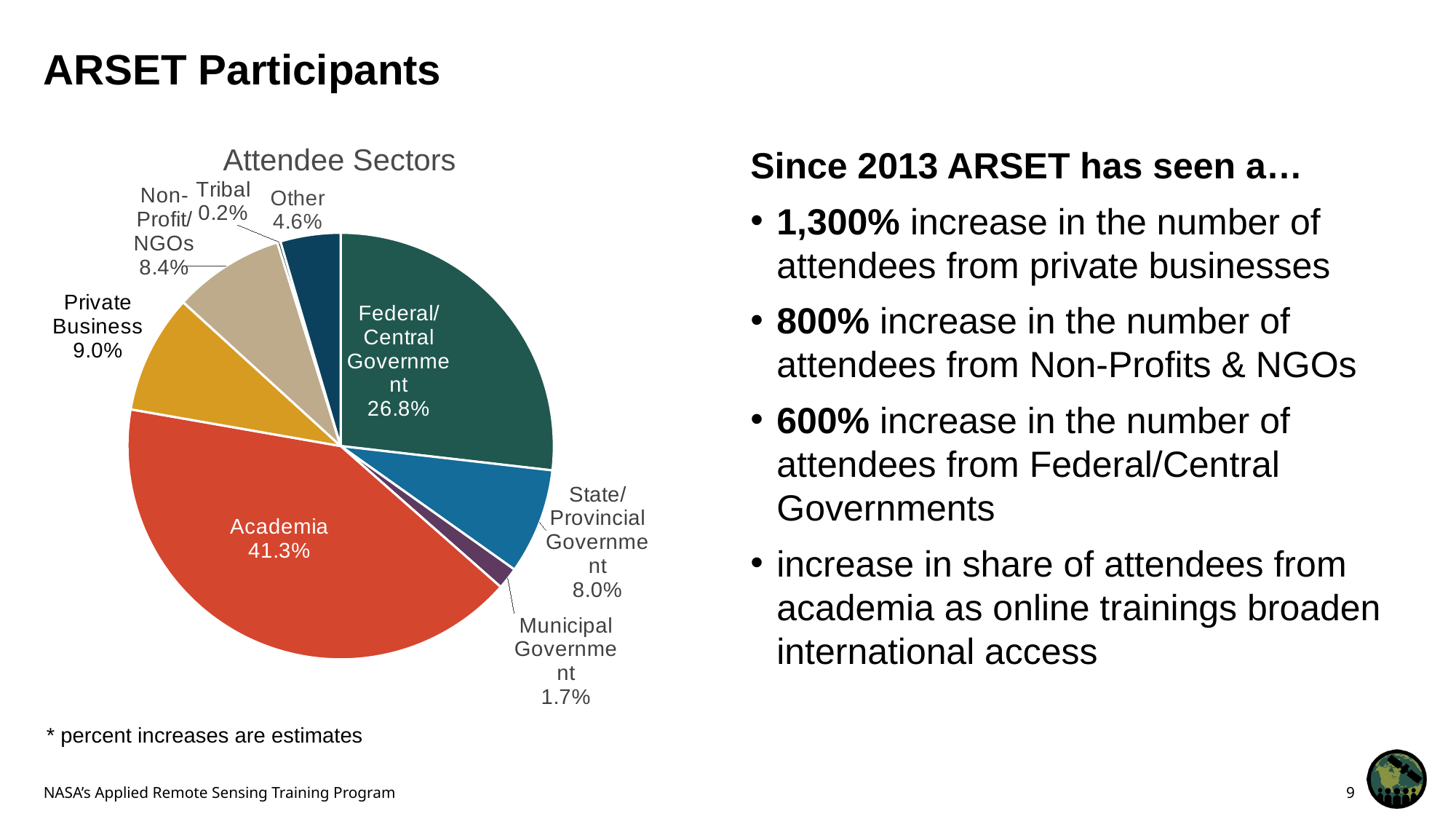
What is the title of the chart? Attendee Sectors What type of chart is shown on the slide? pie chart Which has a larger share, Non-Profit/NGOs or State/Provincial Government? Non-Profit/NGOs Which sector has the smallest share of attendees? Tribal Which sector has the largest share of attendees? Academia What is the difference between the Academia share and the Federal/Central Government share? 14.5% What share of attendees comes from Federal/Central Government? 26.8% How many sectors are shown in the pie chart? 8 What share of attendees comes from Academia? 41.3% What share of attendees comes from Tribal? 0.2% What share of attendees comes from Private Business? 9.0% What is the difference between the Private Business share and the Other share? 4.4%